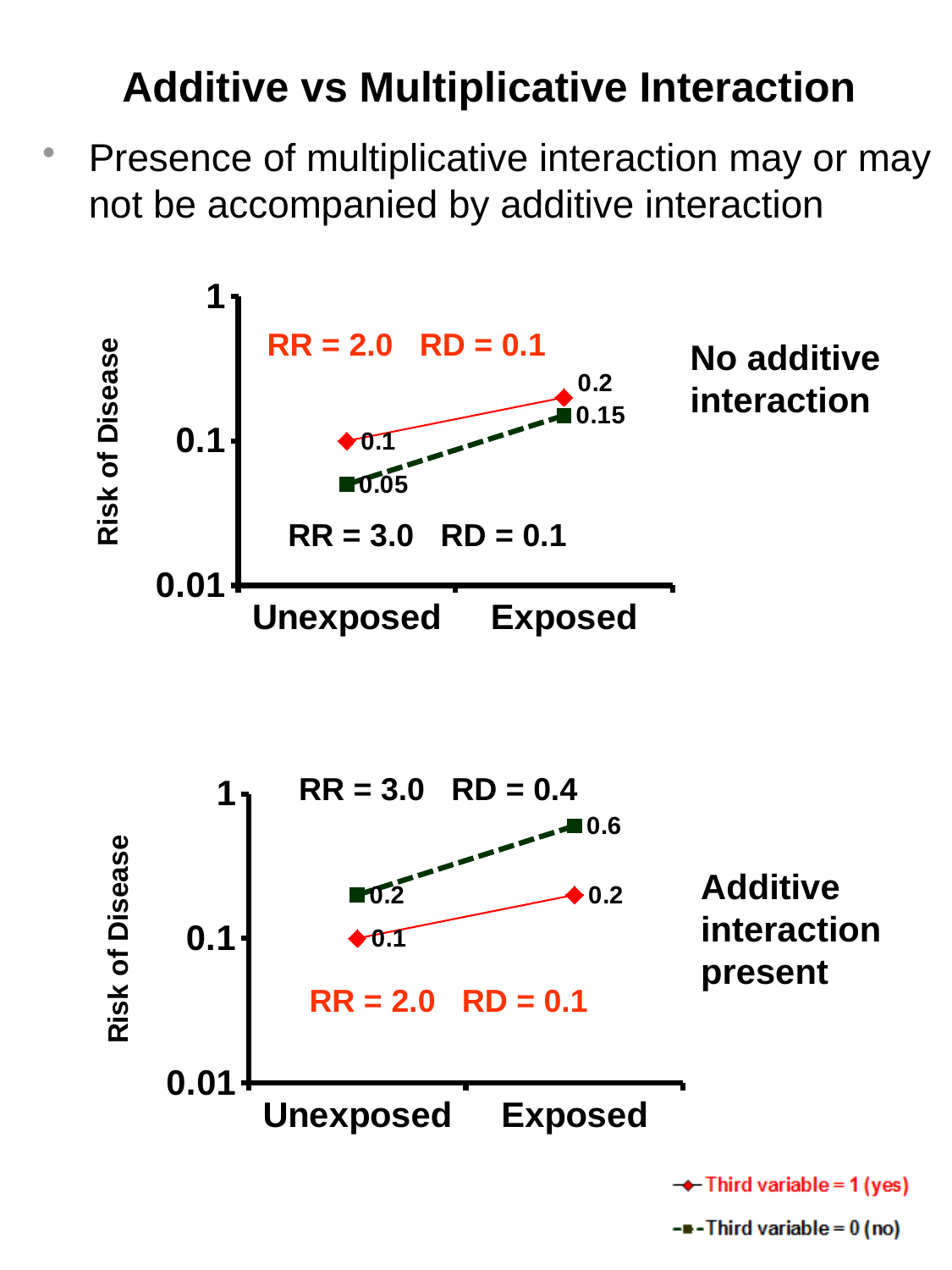
In the top chart, what is the risk of disease for the Exposed group when the third variable = 1 (yes)? 0.2 In the top chart, what is the difference in risk between Exposed and Unexposed for the third variable = 0 (no) series? 0.1 In the top chart, what is the risk of disease for the Unexposed group when the third variable = 0 (no)? 0.05 In the top chart, which series has the higher risk of disease for the Unexposed group? Third variable = 1 (yes) In the top chart, does the risk of disease rise or fall from Unexposed to Exposed? rise What type of chart is shown in the top chart? line chart In the bottom chart, what is the difference in risk between Exposed and Unexposed for the third variable = 0 (no) series? 0.4 In the bottom chart, which series has the higher risk of disease for the Exposed group? Third variable = 0 (no) In the bottom chart, what is the risk of disease for the Unexposed group when the third variable = 1 (yes)? 0.1 In the bottom chart, which plotted point has the highest risk of disease? Exposed, third variable = 0 (no) In the bottom chart, what is the risk of disease for the Exposed group when the third variable = 0 (no)? 0.6 How many series does the legend list? 2